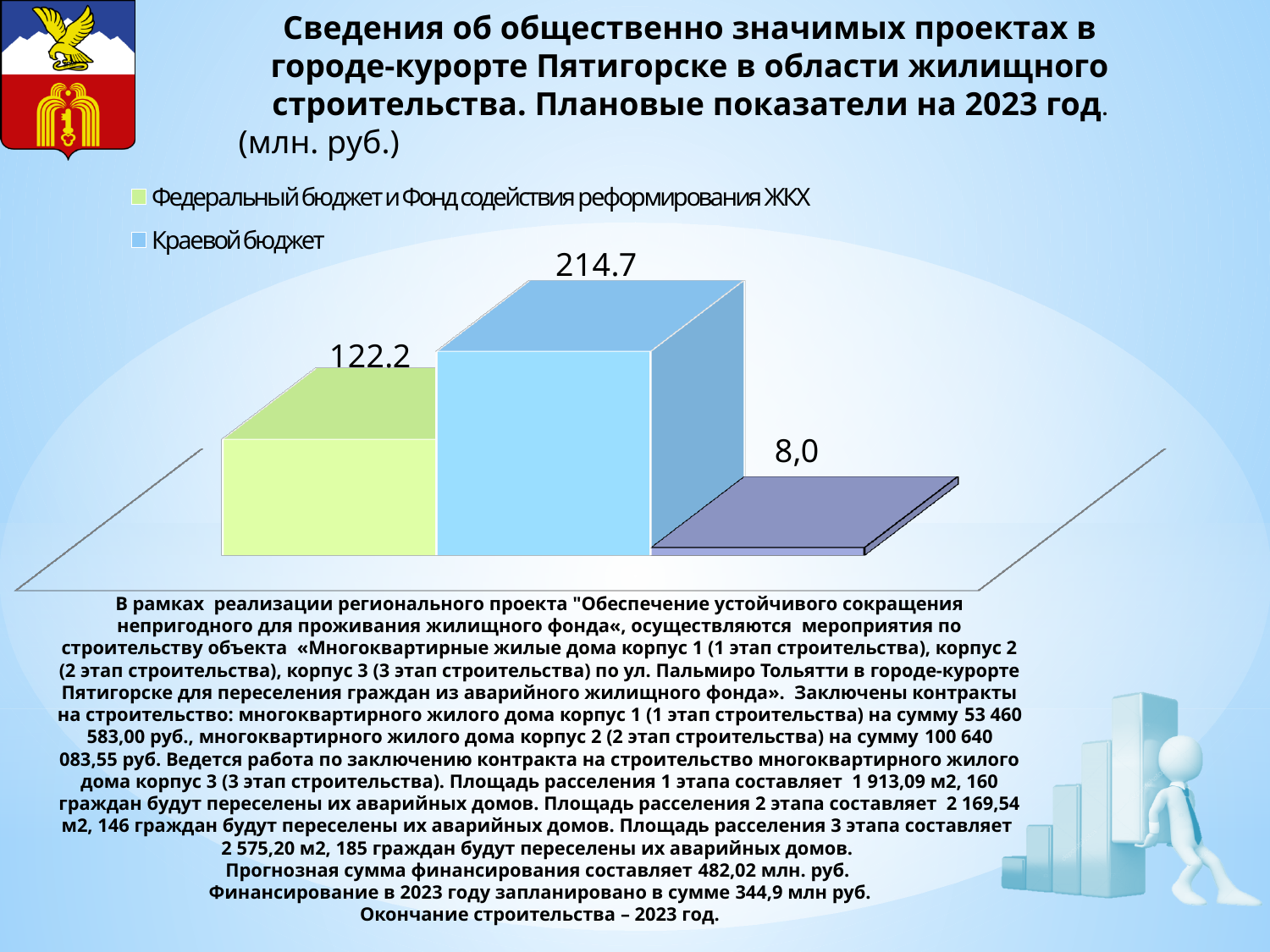
Which legend category has the highest value? Краевой бюджет What is the value for Краевой бюджет? 214.7 What unit is stated for the chart values? млн. руб. What colour is the bar for Краевой бюджет? Blue What kind of chart is shown on the slide? Bar chart How many bars are plotted on the chart? 3 How many entries does the legend list? 2 What is the difference between the value for Краевой бюджет and the value for Федеральный бюджет и Фонд содействия реформирования ЖКХ? 92.5 What is the value for Федеральный бюджет и Фонд содействия реформирования ЖКХ? 122.2 Which is larger: the value for Краевой бюджет or the value for Федеральный бюджет и Фонд содействия реформирования ЖКХ? Краевой бюджет What is the value shown on the smallest bar? 8,0